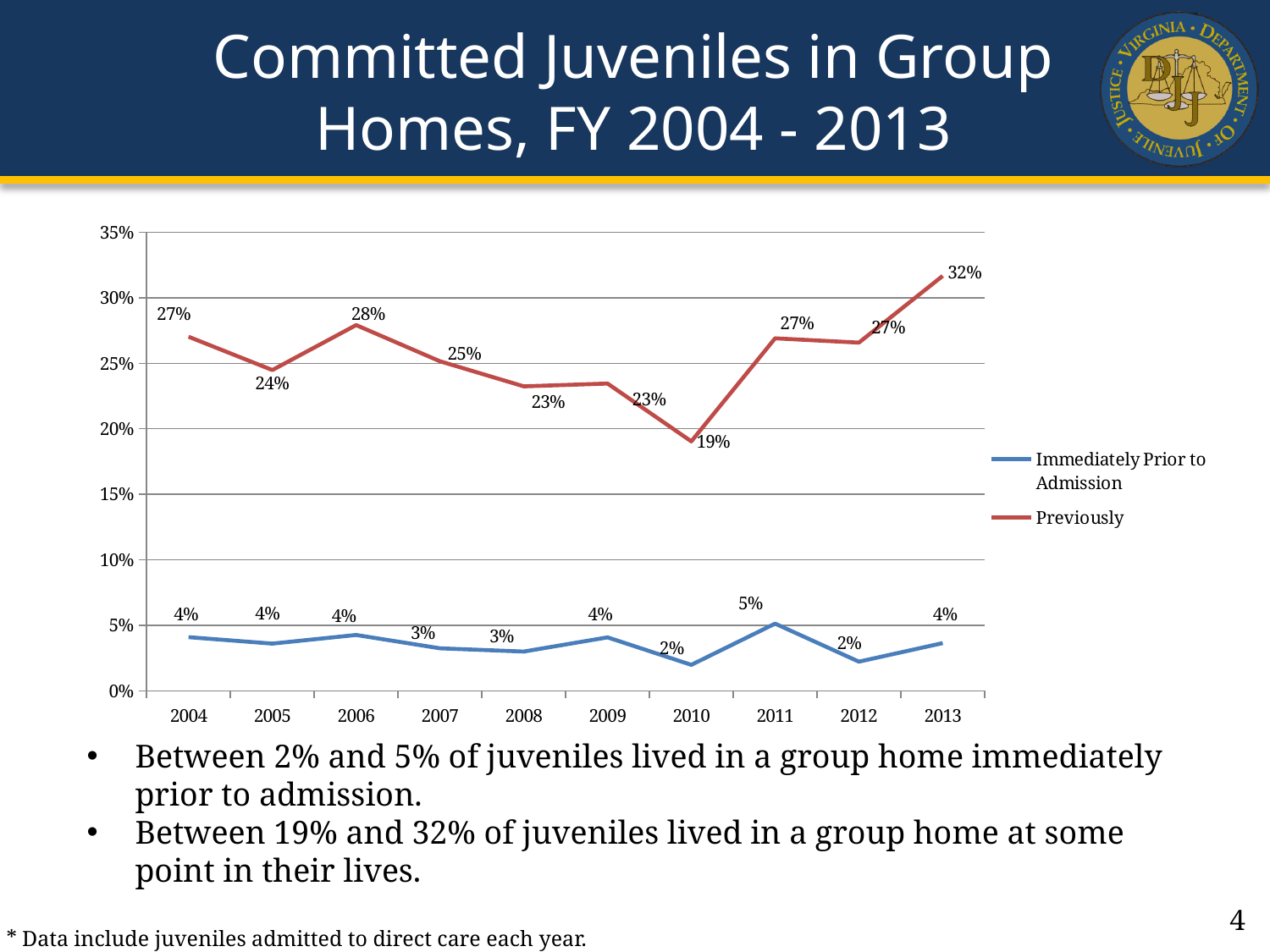
Which colour is used for the Previously series? Red How many years are shown on the x axis? 10 Does the Previously series rise or fall from 2010 to 2013? Rise What is the value for Previously in 2013? 32% In which year is the Previously series at its highest? 2013 What is the value for Previously in 2010? 19% How many series does the legend list? 2 What is the difference between the Previously value in 2013 and the Previously value in 2010? 13% In which year is the Previously series at its lowest? 2010 What is the value for Immediately Prior to Admission in 2011? 5% Which is larger in 2006: the Previously value or the Immediately Prior to Admission value? Previously What type of chart is shown on the slide? Line chart